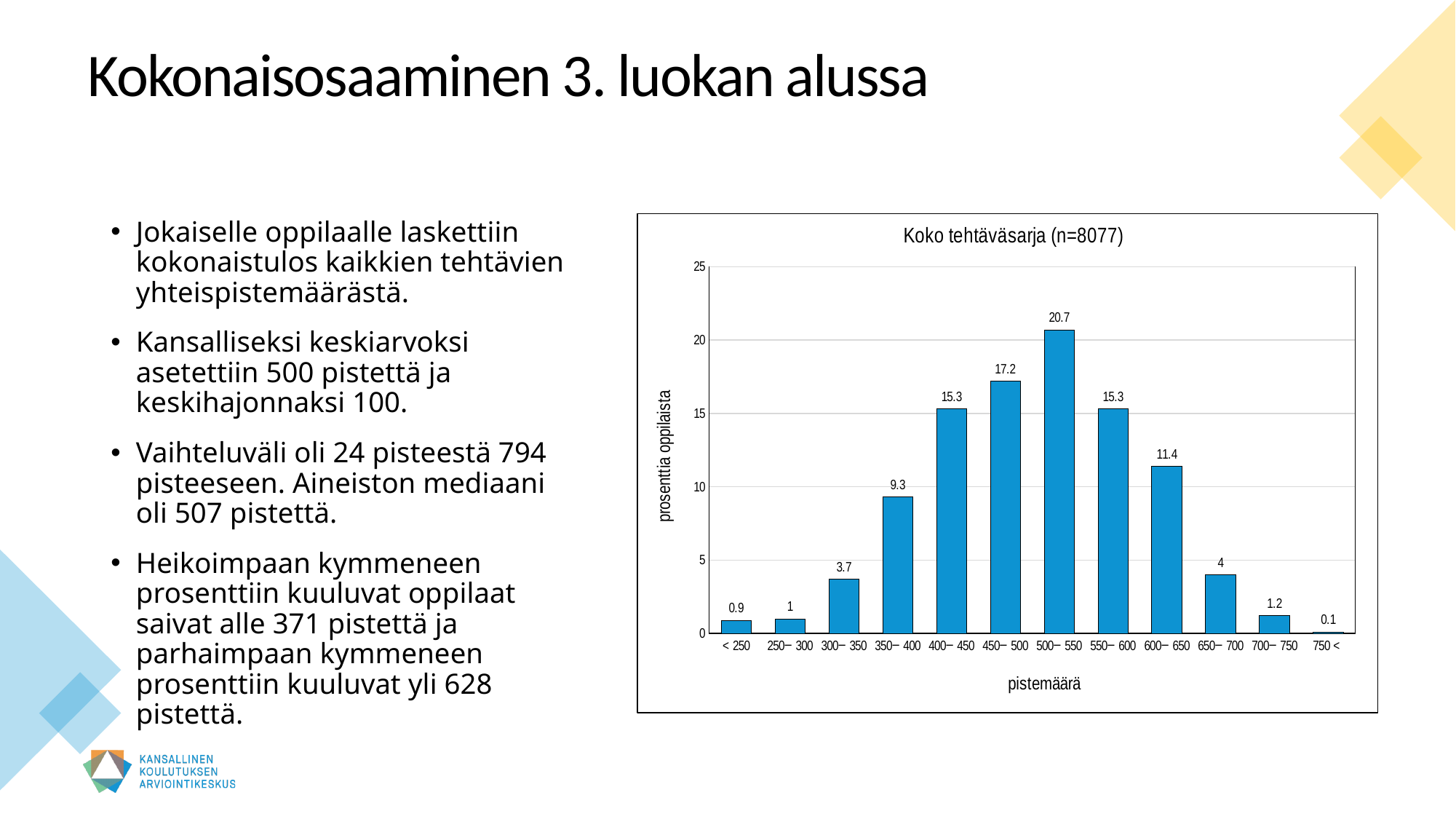
How many score-range categories are shown on the x axis? 12 What is the title of the chart? Koko tehtäväsarja (n=8077) What is the difference between the values for 500–550 and 450–500? 3.5 What is the value for the < 250 category? 0.9 What is the value for the 350–400 score range? 9.3 What kind of chart is shown on the slide? bar chart Which score range has the highest percentage of pupils? 500–550 What is the label of the y axis? prosenttia oppilaista What percentage of pupils scored in the 500–550 range? 20.7 Which is larger, the value for 600–650 or the value for 350–400? 600–650 Which score range has the lowest percentage of pupils? 750 < Is the value for 450–500 greater or less than 15? greater